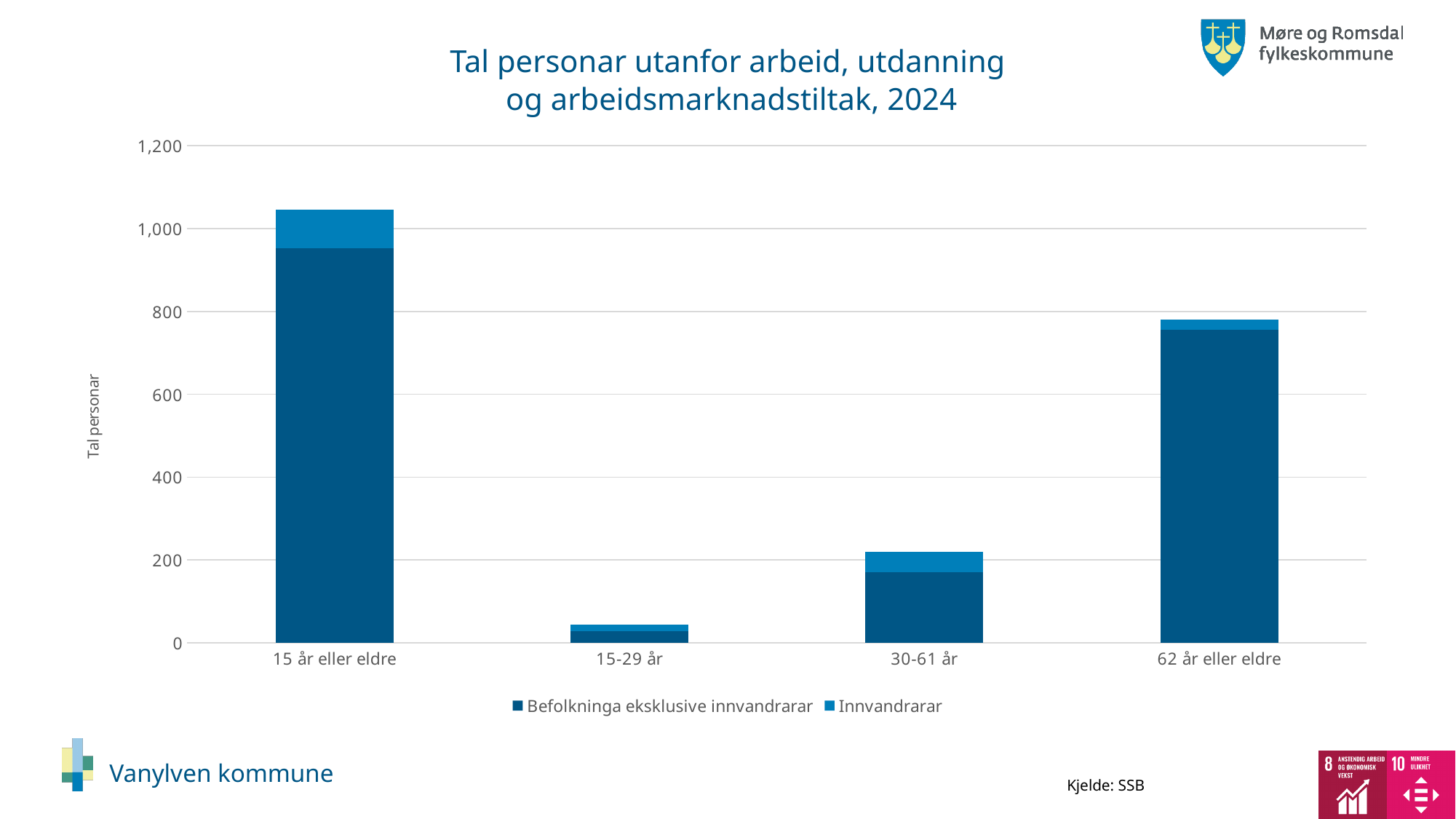
Which category has the tallest stacked bar? 15 år eller eldre Which category has the shortest stacked bar? 15-29 år How many age categories are shown on the x axis? 4 What is the label of the y axis? Tal personar Is the total stacked bar for 62 år eller eldre greater or less than 800? less What kind of chart is shown on the slide? Stacked bar chart Is the total stacked bar for 15-29 år greater or less than 200? less What is the title of the chart? Tal personar utanfor arbeid, utdanning og arbeidsmarknadstiltak, 2024 Is the total stacked bar for 15 år eller eldre greater or less than 1,000? greater Which has the larger total stacked bar, 62 år eller eldre or 30-61 år? 62 år eller eldre How many series does the legend list? 2